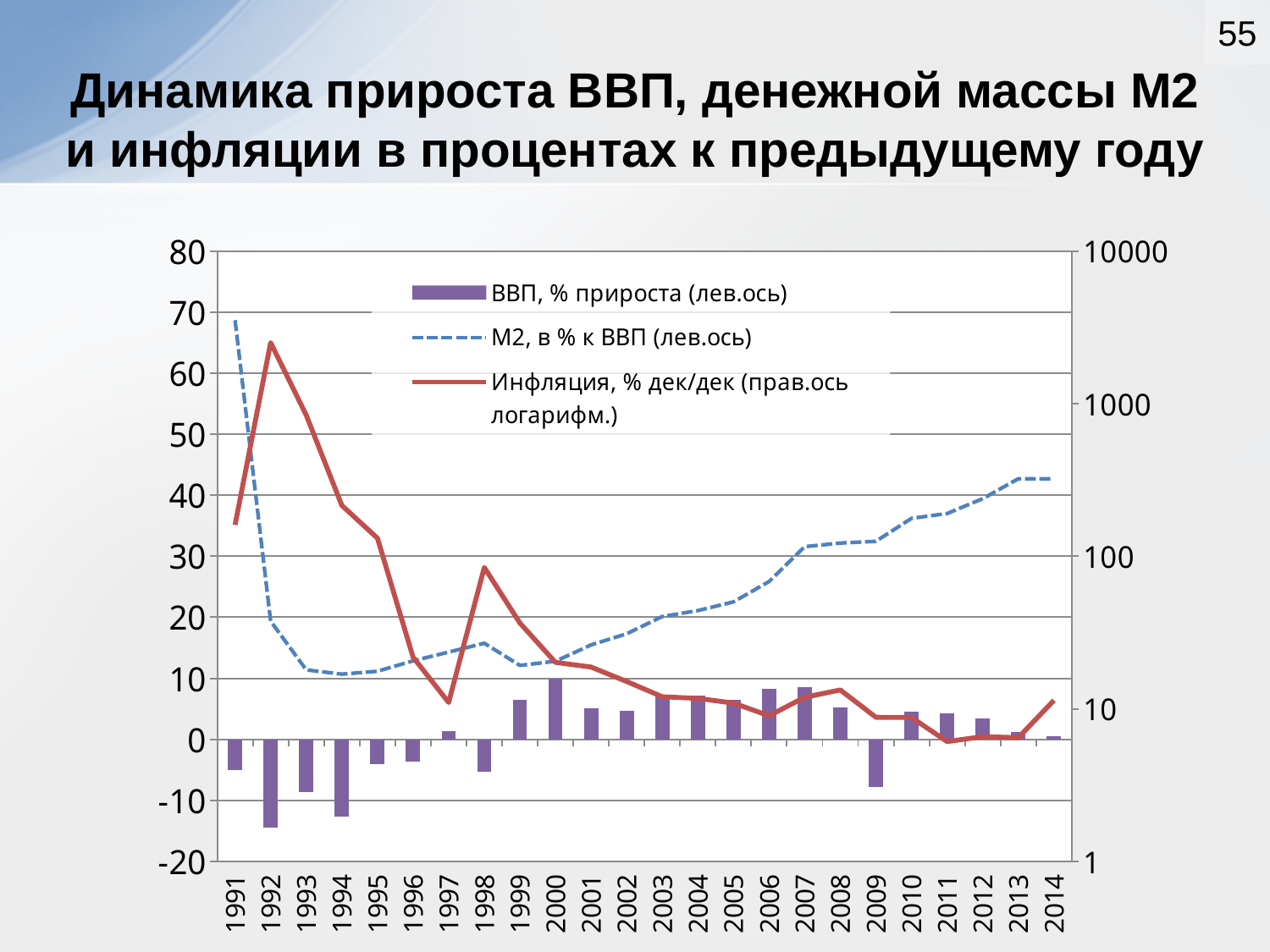
What kind of chart is this? Combined bar and line chart Which is larger, the ВВП, % прироста value for 2000 or for 2009? 2000 In which year does the Инфляция, % дек/дек line reach its peak? 1992 Is the value of Инфляция, % дек/дек for 1992 greater or less than 1000? greater In which year is the bar for ВВП, % прироста the highest? 2000 Is the value of ВВП, % прироста for 1992 greater or less than -10? less Is the value of М2, в % к ВВП for 2014 greater or less than 40? greater How many years are shown along the x axis? 24 Does the М2, в % к ВВП line rise or fall from 2000 to 2014? rise How many series does the legend list? 3 In which year is the bar for ВВП, % прироста the lowest? 1992